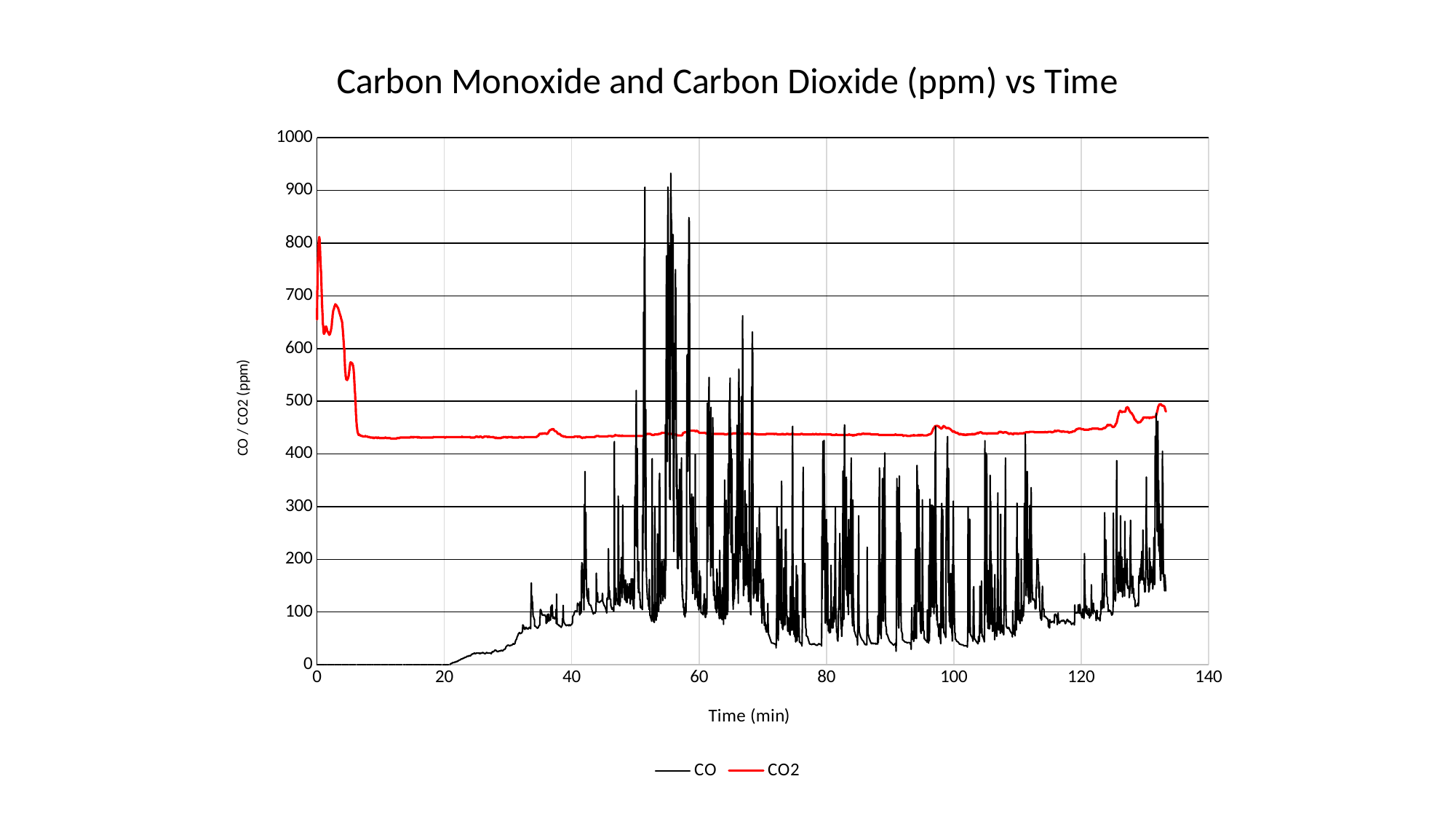
Which series is higher at 10 min, CO or CO2? CO2 Which colour is used for the CO2 series? red Which series reaches the higher peak value on the chart, CO or CO2? CO What kind of chart is shown on the slide? line chart Is the CO value at 10 min greater or less than 100? less What is the title of the chart? Carbon Monoxide and Carbon Dioxide (ppm) vs Time Is the CO2 value at 100 min greater or less than 400? greater Is the highest CO value on the chart greater or less than 900? greater Does the CO2 value rise or fall between 0 and 10 min? fall How many series does the legend list? 2